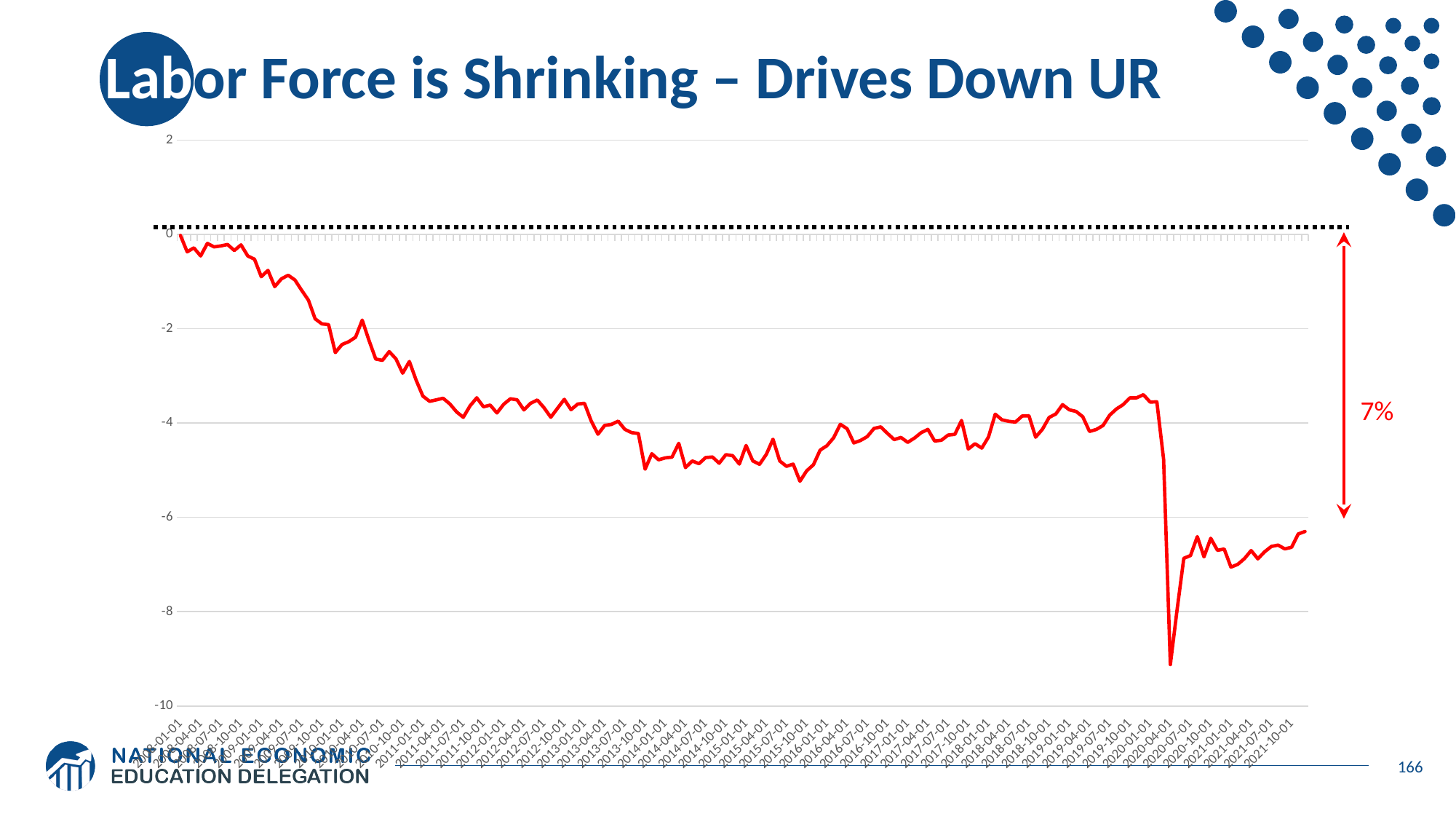
Is the value of the red line at 2016-01-01 greater or less than -2? less Is the value of the red line at 2008-01-01 greater or less than -2? greater Which is larger, the value of the red line at 2008-01-01 or at 2020-04-01? 2008-01-01 Around which x-axis date is the red line at its highest value? 2008-01-01 Is the value of the red line at 2021-10-01 greater or less than -8? greater Around which x-axis date does the red line reach its lowest point? 2020-04-01 What is the title of the slide's chart? Labor Force is Shrinking – Drives Down UR What percentage is written next to the red double-headed arrow on the right of the chart? 7% What kind of chart is shown on the slide? line chart Overall, does the red line rise or fall from 2008-01-01 to 2021-10-01? fall What is the lowest value shown on the y-axis? -10